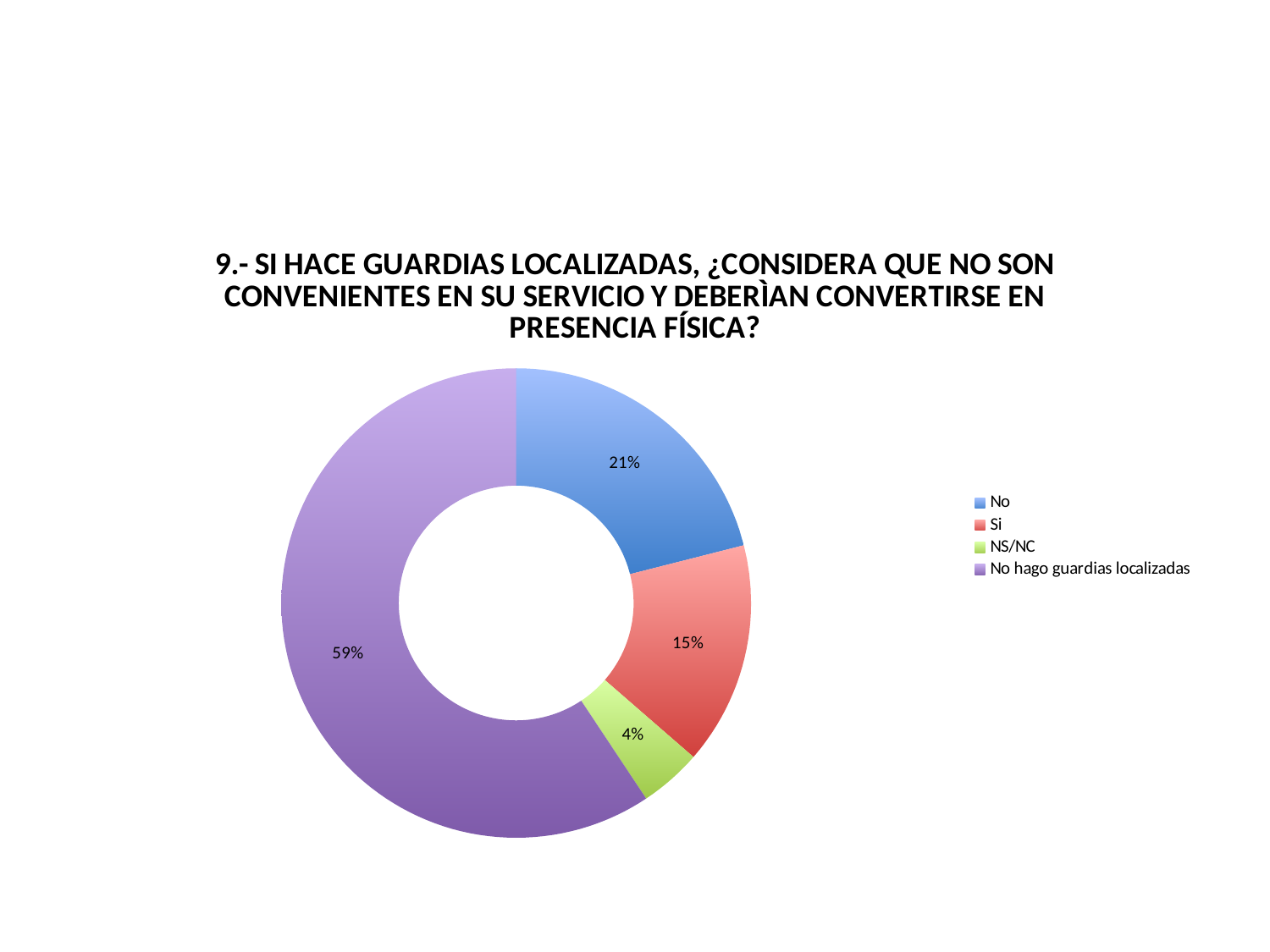
What share of the chart does the "NS/NC" slice represent? 4% What share of the chart does the "No hago guardias localizadas" slice represent? 59% What colour is the "NS/NC" slice? Green What is the difference in percentage points between the "No hago guardias localizadas" slice and the "No" slice? 38 What share of the chart does the "Si" slice represent? 15% Which is larger, the "No" slice or the "Si" slice? No Which category has the largest slice? No hago guardias localizadas What kind of chart is shown on the slide? Doughnut (pie) chart Which category has the smallest slice? NS/NC What is the difference in percentage points between the "No" slice and the "Si" slice? 6 How many categories does the chart show? 4